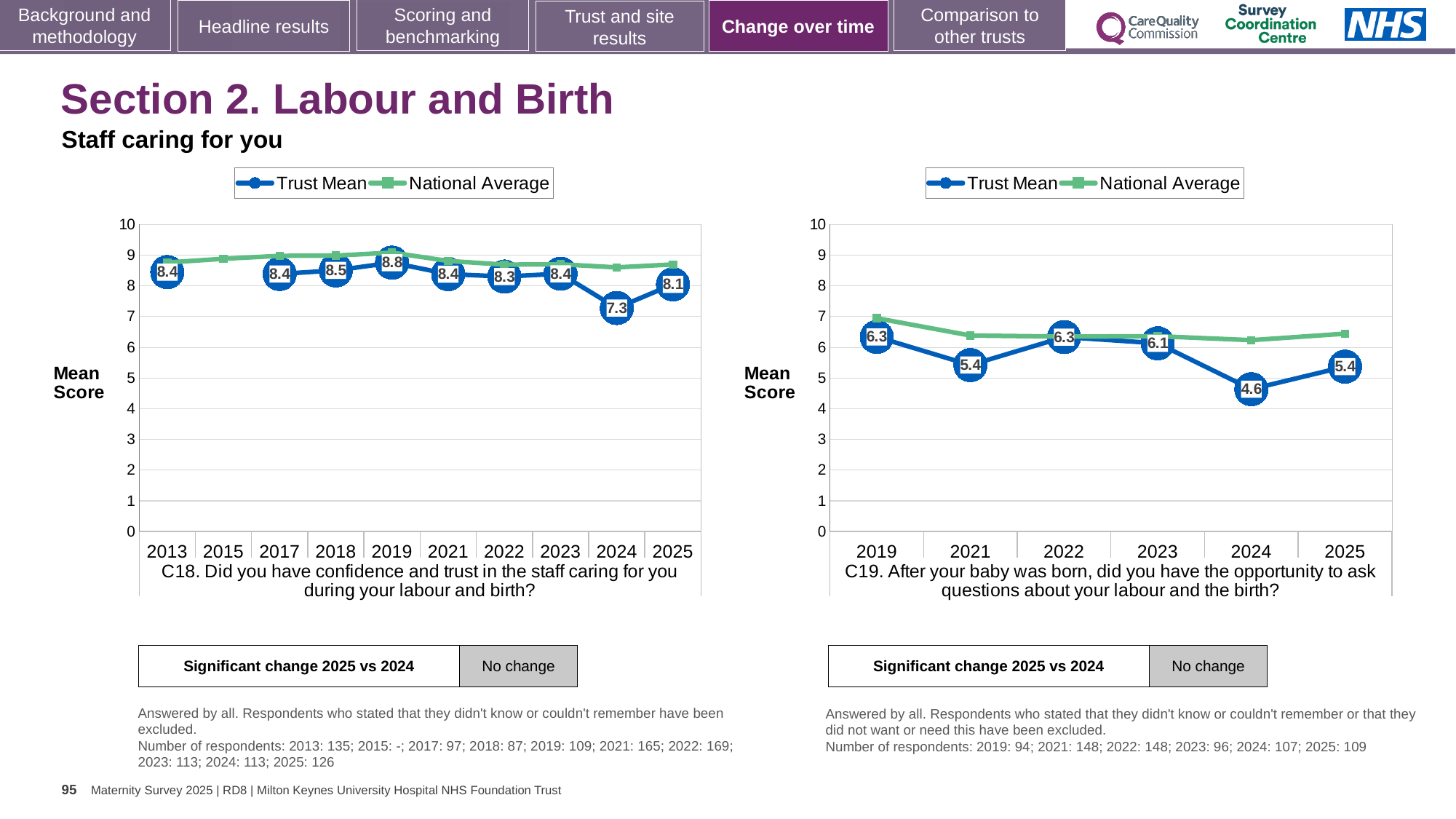
In the C18 chart, what is the Trust Mean score for 2019? 8.8 How many series does the legend of the C19 chart list? 2 In the C18 chart, what is the Trust Mean score for 2024? 7.3 In the C18 chart, how many years are shown on the x axis? 10 In the C19 chart, is the National Average for 2019 greater or less than 6? greater In the C19 chart, what is the difference between the Trust Mean scores for 2025 and 2024? 0.8 In the C19 chart, what is the Trust Mean score for 2024? 4.6 In the C18 chart, what is the difference between the Trust Mean scores for 2019 and 2024? 1.5 In the C18 chart, which year has the lowest Trust Mean score? 2024 In the C19 chart, which year has the lowest Trust Mean score? 2024 In the C19 chart, is the Trust Mean score for 2021 or 2023 higher? 2023 What type of chart is the C18 chart? Line chart